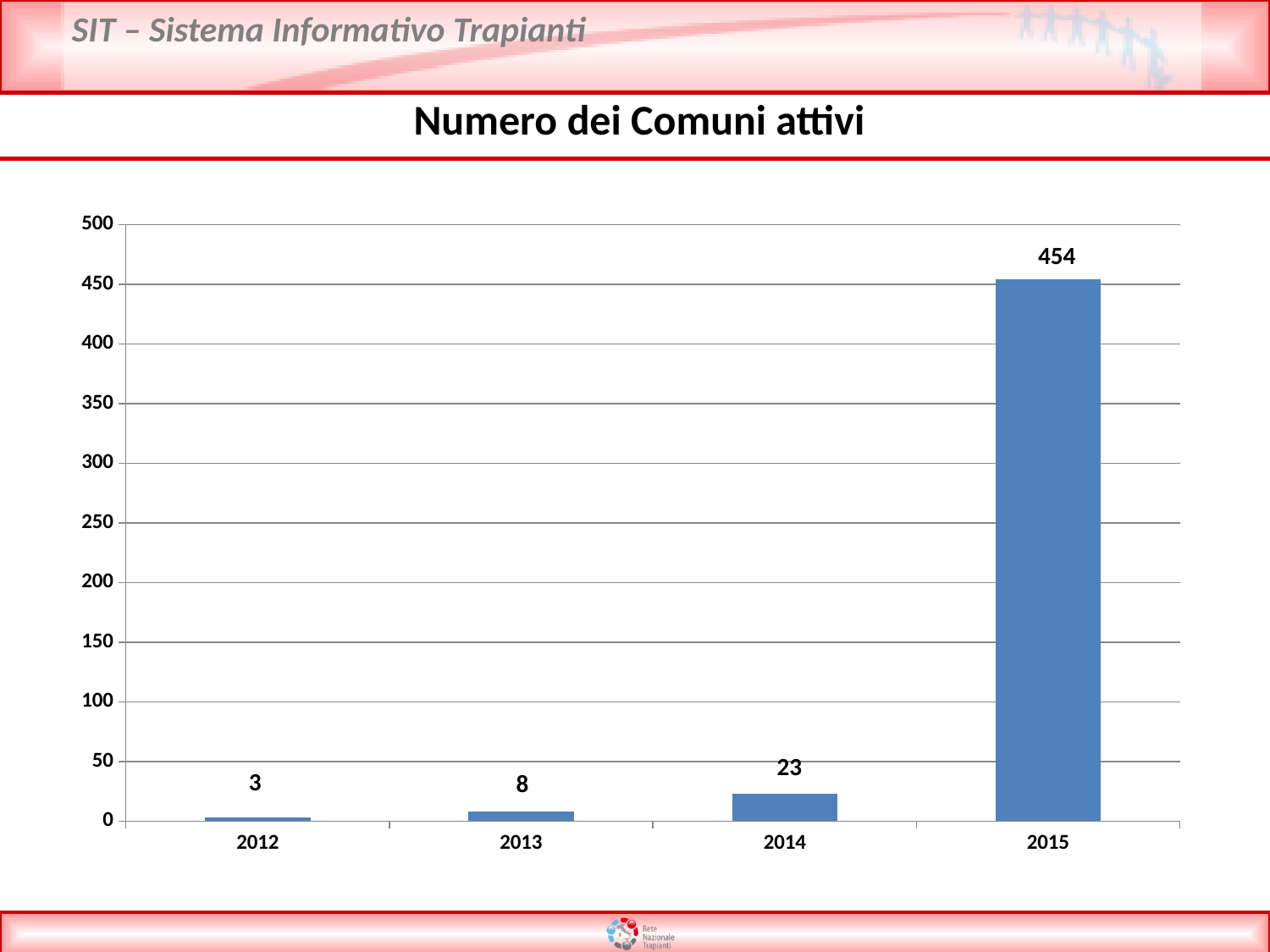
What is the difference between the values for 2013 and 2012? 5 What is the value shown for 2012? 3 What is the value shown for 2013? 8 Is the value for 2015 greater or less than 400? greater What is the number of active municipalities (Comuni attivi) in 2015? 454 What kind of chart is shown on the slide? Bar chart What is the value shown for 2014? 23 What is the difference between the values for 2015 and 2014? 431 Which year has a larger value, 2013 or 2014? 2014 How many years are shown on the x axis? 4 Which year has the lowest number of active municipalities? 2012 Which year has the highest number of active municipalities? 2015